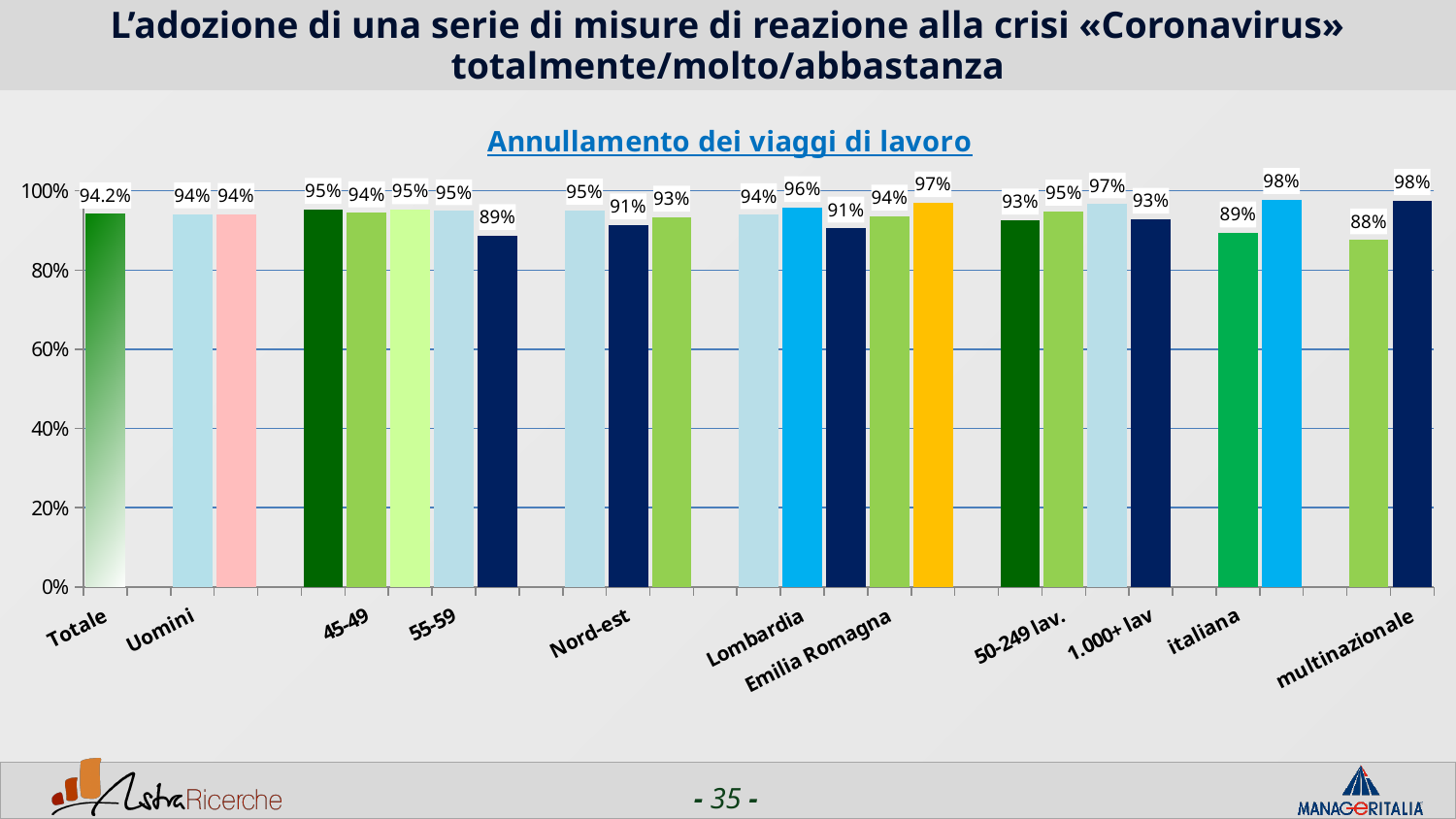
What is the value for multinazionale? 98% What is the value for Totale? 94.2% What is the value for italiana? 89% What is the value for Nord-est? 91% What kind of chart is shown on the slide? Bar chart What is the difference between the values for multinazionale and italiana? 9 percentage points What is the value for Lombardia? 96% What is the title of the chart? Annullamento dei viaggi di lavoro What is the value for Uomini? 94% Is the value for 1.000+ lav greater or less than 80%? greater What is the value for 50-249 lav.? 95% Which is larger, the value for Lombardia or the value for Emilia Romagna? Lombardia